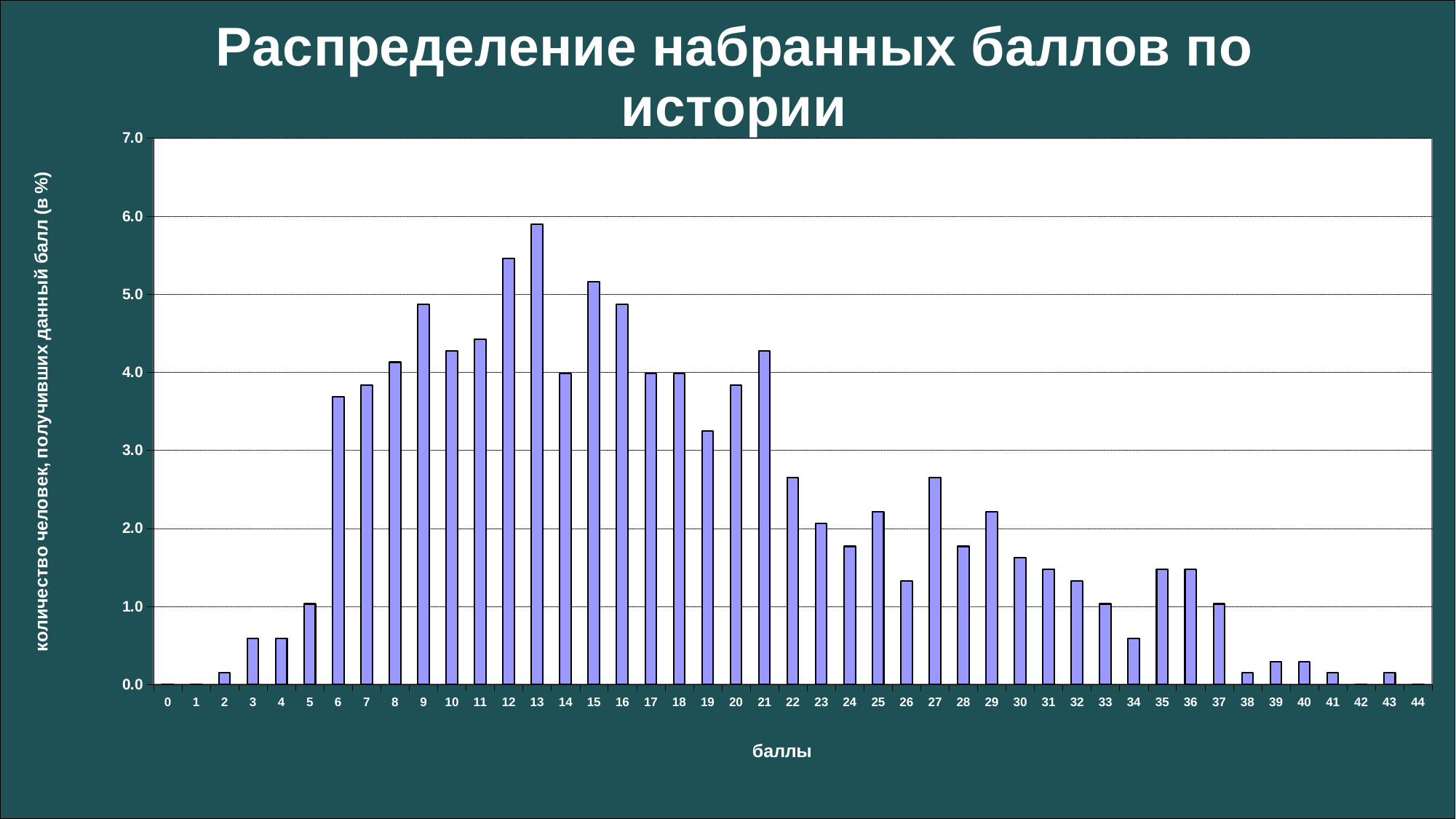
Is the value for score 13 greater or less than 5.0? greater What is the title of the chart? Распределение набранных баллов по истории What is the label of the x axis? баллы Is the value for score 22 greater or less than 2.0? greater Do the values generally rise or fall from score 21 to score 44? fall Is the value for score 6 greater or less than 4.0? less How many score categories are shown on the x axis? 45 Which has a larger value, score 27 or score 28? 27 What kind of chart is shown on the slide? bar chart Which score has the highest percentage of people? 13 Which has a larger value, score 9 or score 10? 9